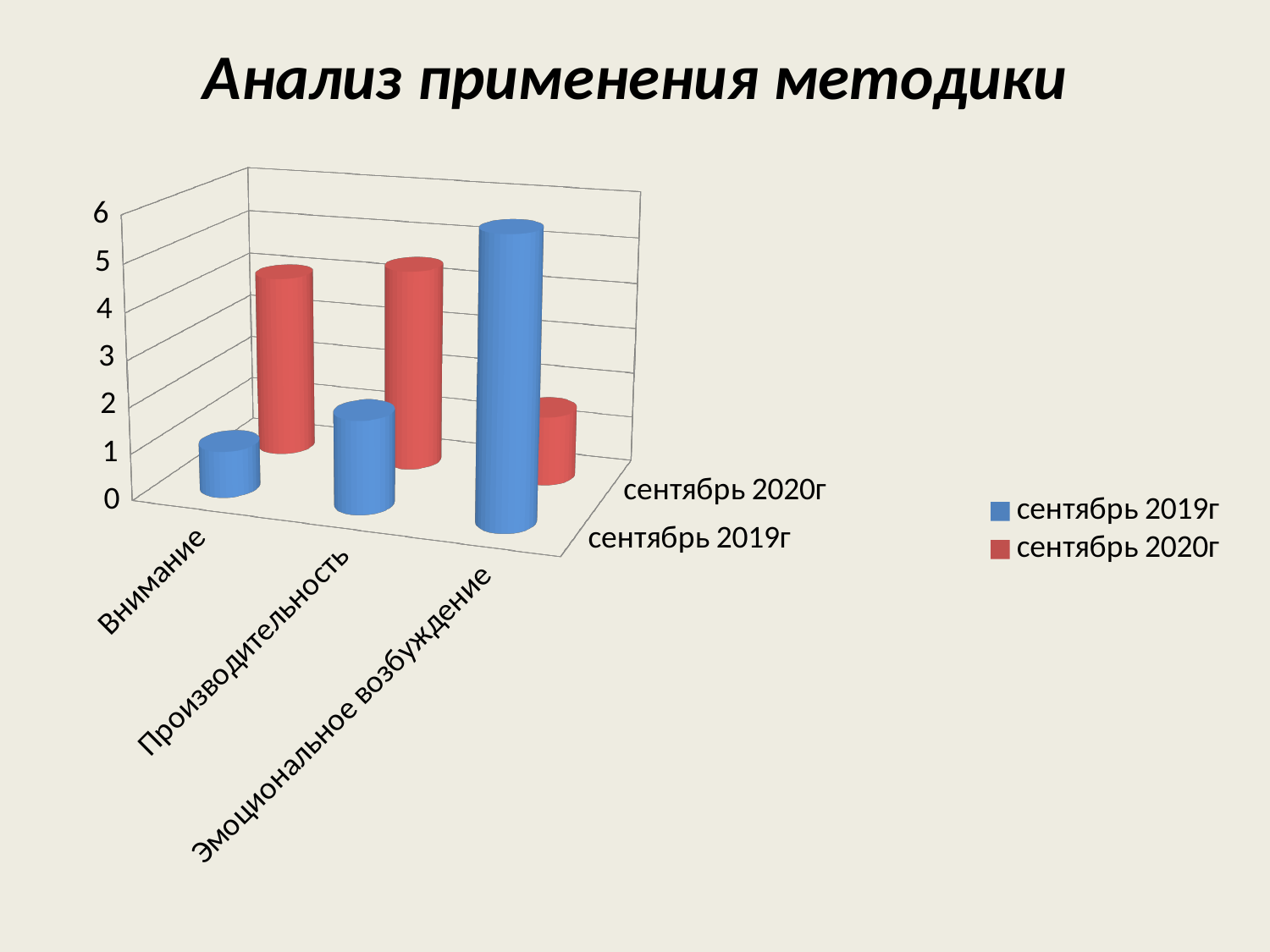
How many categories are shown on the chart's category axis? 3 What kind of chart is shown on the slide? bar chart What is the title of the slide? Анализ применения методики For the series сентябрь 2020г, which category has the lowest value? Эмоциональное возбуждение For the series сентябрь 2019г, which category has the lowest value? Внимание Is the value for Внимание in сентябрь 2019г greater or less than 3? less For Эмоциональное возбуждение, which series has the larger value, сентябрь 2019г or сентябрь 2020г? сентябрь 2019г Is the value for Эмоциональное возбуждение in сентябрь 2019г greater or less than 4? greater For the series сентябрь 2019г, which category has the highest value? Эмоциональное возбуждение How many series does the legend list? 2 For Внимание, which series has the larger value, сентябрь 2019г or сентябрь 2020г? сентябрь 2020г Which colour represents the series сентябрь 2020г in the legend? red